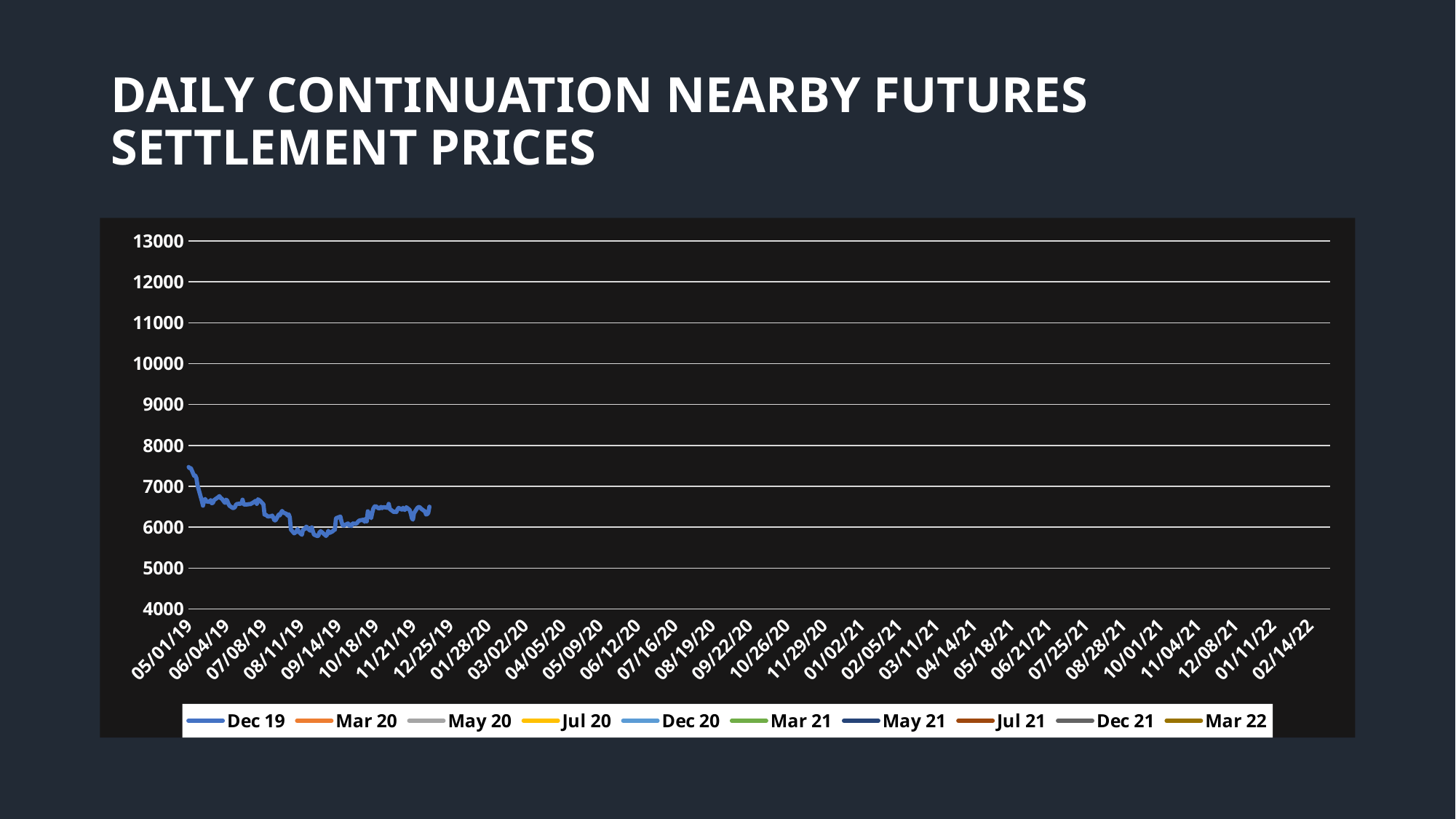
How many series does the legend list? 10 Which series is the only one with data plotted on the chart? Dec 19 How many date labels are shown on the x axis? 31 Does the Dec 19 series rise or fall between 09/14/19 and 10/18/19? rise Is the value of the Dec 19 series at 10/18/19 greater or less than 6000? greater What is the title of the chart? DAILY CONTINUATION NEARBY FUTURES SETTLEMENT PRICES Is the value of the Dec 19 series at 05/01/19 greater or less than 7000? greater What kind of chart is shown on the slide? line chart Does the Dec 19 series ever rise above 8000? No What is the highest value shown on the vertical axis? 13000 Does the Dec 19 series rise or fall between 05/01/19 and 08/11/19? fall